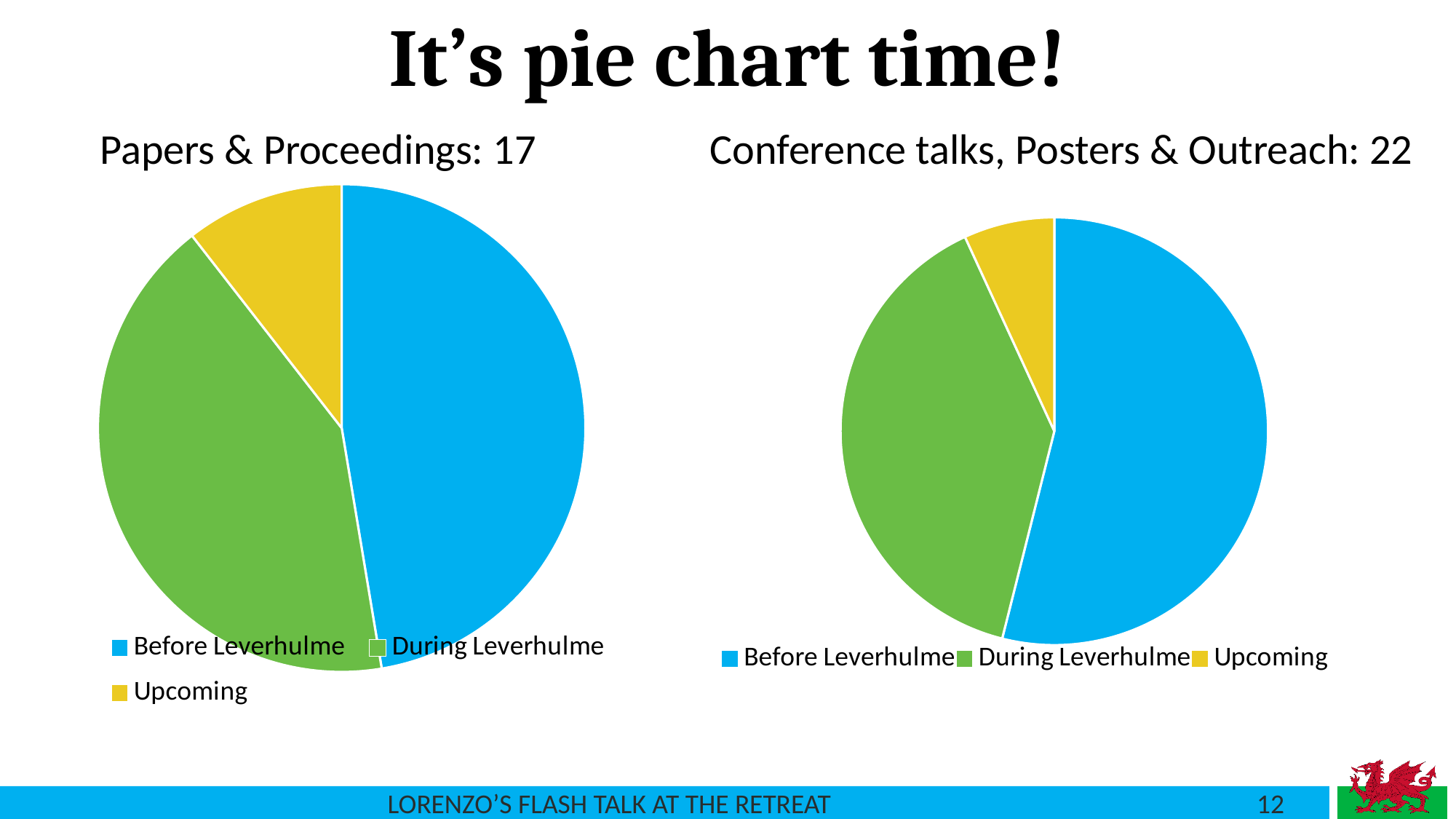
In the "Papers & Proceedings: 17" pie chart, which category has the smallest slice? Upcoming Which colour represents "Upcoming" in the legend of the right pie chart? yellow In the "Conference talks, Posters & Outreach: 22" pie chart, which category has the smallest slice? Upcoming In the "Papers & Proceedings: 17" pie chart, which slice is larger: During Leverhulme or Upcoming? During Leverhulme What kind of chart is the "Papers & Proceedings: 17" chart? pie chart In the "Papers & Proceedings: 17" pie chart, which category has the largest slice? Before Leverhulme What total is given in the title of the left pie chart, "Papers & Proceedings"? 17 How many entries does the legend of the "Conference talks, Posters & Outreach: 22" pie chart list? 3 How many slices does the "Papers & Proceedings: 17" pie chart have? 3 In the "Conference talks, Posters & Outreach: 22" pie chart, which category has the largest slice? Before Leverhulme What kind of chart is the "Conference talks, Posters & Outreach: 22" chart? pie chart In the "Conference talks, Posters & Outreach: 22" pie chart, which slice is larger: Before Leverhulme or During Leverhulme? Before Leverhulme